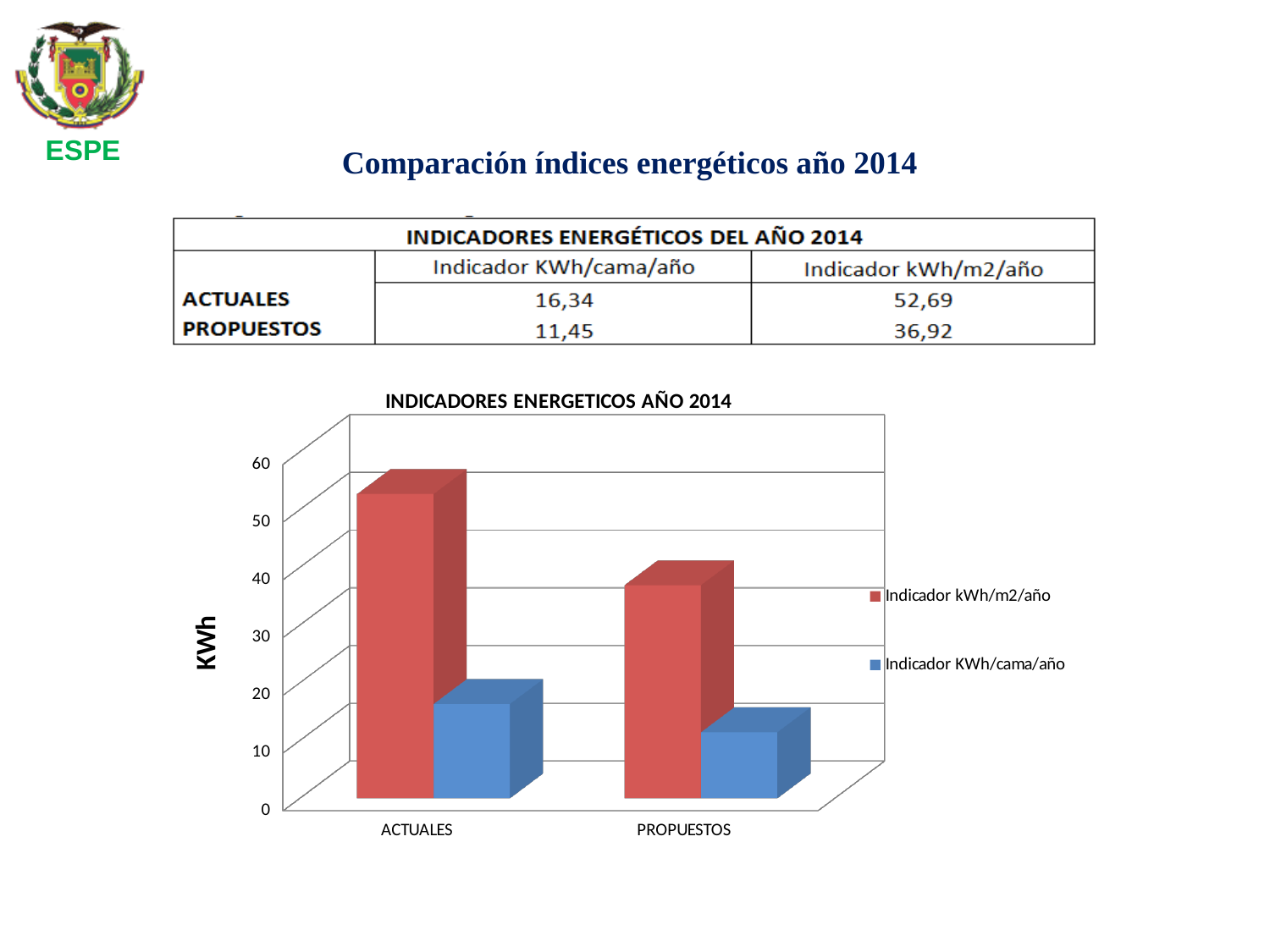
Is the Indicador kWh/m2/año value for PROPUESTOS greater or less than 40? less How many series does the chart legend list? 2 What is the title of the chart? INDICADORES ENERGETICOS AÑO 2014 What is the difference between the Indicador kWh/m2/año values for ACTUALES and PROPUESTOS? 15,77 What is the value of Indicador KWh/cama/año for PROPUESTOS? 11,45 What is the value of Indicador kWh/m2/año for ACTUALES? 52,69 Do the values for Indicador KWh/cama/año rise or fall from ACTUALES to PROPUESTOS? fall Which category has the highest value for Indicador kWh/m2/año? ACTUALES What type of chart is shown on the slide? bar chart How many categories are shown on the x axis of the chart? 2 Which is larger for ACTUALES: Indicador kWh/m2/año or Indicador KWh/cama/año? Indicador kWh/m2/año Which category has the lowest value for Indicador KWh/cama/año? PROPUESTOS